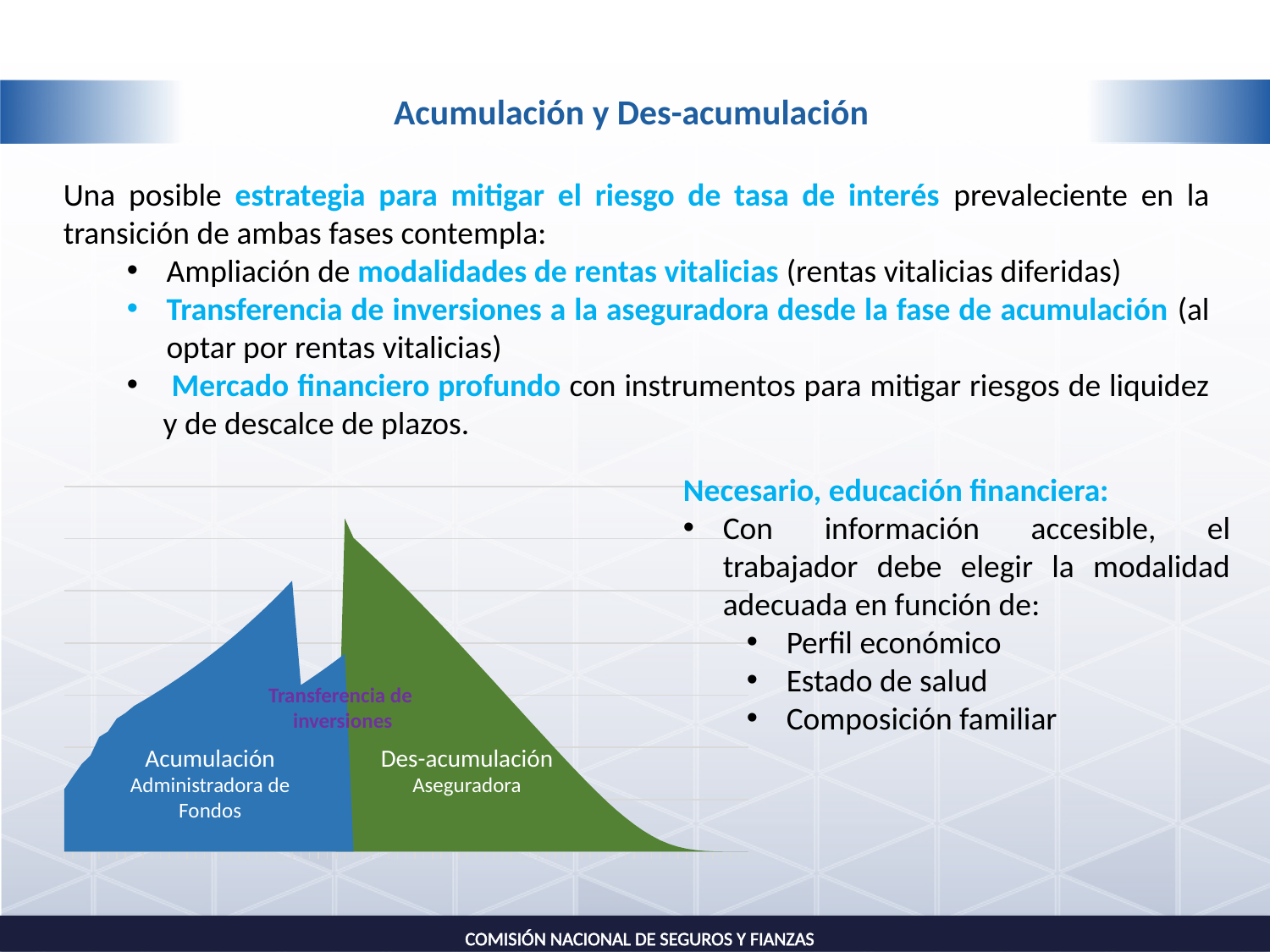
Which phase comes first along the x axis, Acumulación or Des-acumulación? Acumulación Which phase is shown in blue on the chart? Acumulación Does the value rise or fall along the x axis during the Des-acumulación phase? Falls How many phases (shaded regions) does the chart show? 2 Does the value rise or fall along the x axis during the Acumulación phase? Rises Which phase is shown in green on the chart? Des-acumulación What kind of chart is shown on the slide? Area chart